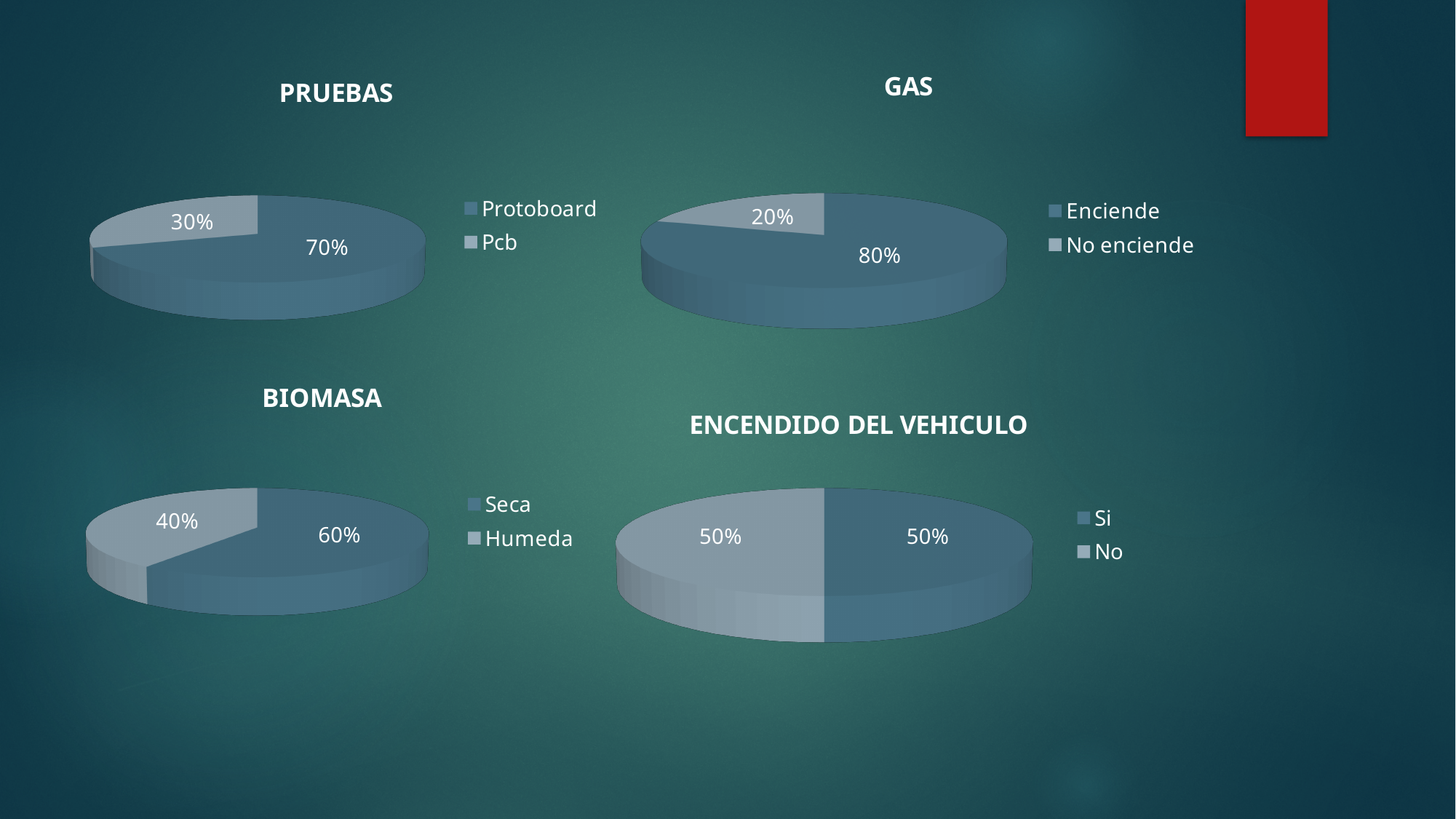
What type of chart is the BIOMASA chart? Pie chart In the PRUEBAS chart, what is the difference in percentage points between Protoboard and Pcb? 40 In the GAS chart, what percentage is shown for Enciende? 80% In the ENCENDIDO DEL VEHICULO chart, what percentage is shown for Si? 50% In the GAS chart, which is larger, Enciende or No enciende? Enciende In the GAS chart, what percentage is shown for No enciende? 20% In the GAS chart, which category has the smallest share? No enciende In the BIOMASA chart, what percentage is shown for Humeda? 40% How many categories does the legend of the ENCENDIDO DEL VEHICULO chart list? 2 In the PRUEBAS chart, what percentage is shown for Protoboard? 70% In the PRUEBAS chart, what percentage is shown for Pcb? 30% In the BIOMASA chart, which category has the largest share? Seca